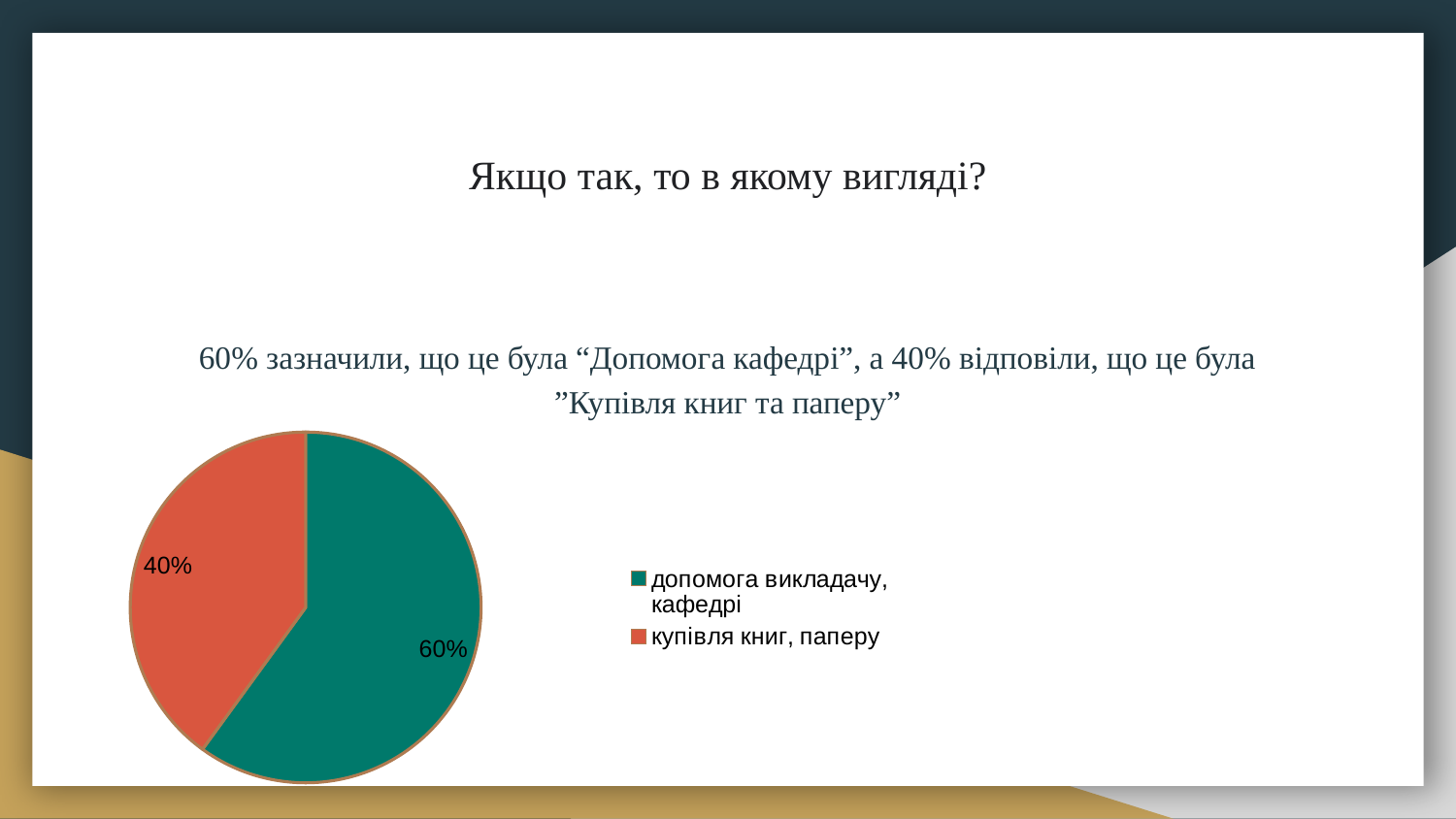
What share of the pie does "купівля книг, паперу" take? 40% Which is larger: the share for "допомога викладачу, кафедрі" or for "купівля книг, паперу"? допомога викладачу, кафедрі Which slice of the pie is the largest? допомога викладачу, кафедрі What share of the pie does "допомога викладачу, кафедрі" take? 60% How many entries does the legend list? 2 What is the difference between the shares of "допомога викладачу, кафедрі" and "купівля книг, паперу"? 20% What kind of chart is shown on the slide? pie chart What colour is the slice for "допомога викладачу, кафедрі"? green Which slice of the pie is the smallest? купівля книг, паперу How many slices does the pie chart have? 2 What colour is the slice for "купівля книг, паперу"? red